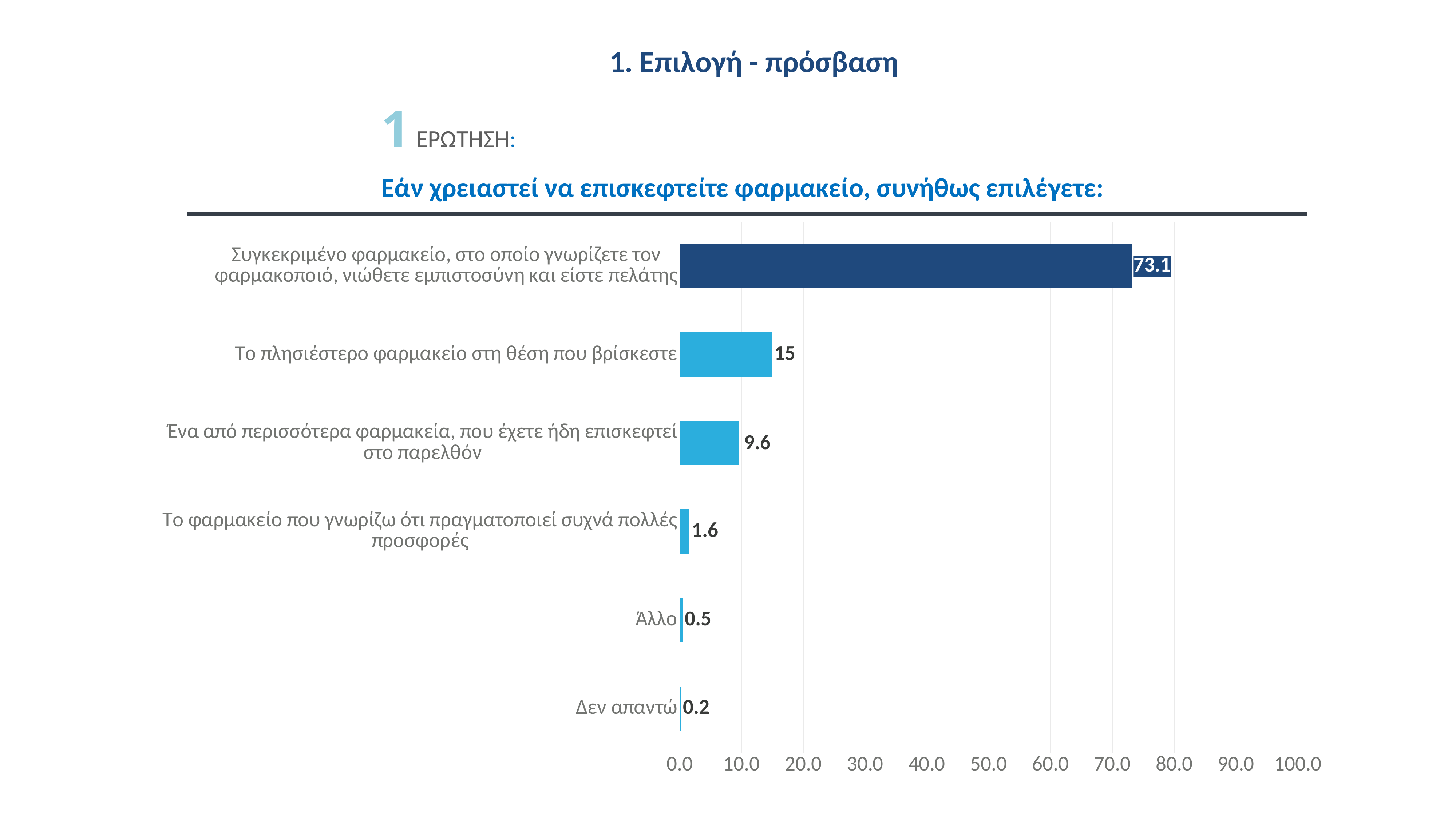
How many categories are shown in the chart? 6 Is the value for "Συγκεκριμένο φαρμακείο, στο οποίο γνωρίζετε τον φαρμακοποιό, νιώθετε εμπιστοσύνη και είστε πελάτης" greater or less than 70.0? greater Which is larger: the value for "Το φαρμακείο που γνωρίζω ότι πραγματοποιεί συχνά πολλές προσφορές" or the value for "Άλλο"? Το φαρμακείο που γνωρίζω ότι πραγματοποιεί συχνά πολλές προσφορές What is the value for "Δεν απαντώ"? 0.2 Which category has the lowest value? Δεν απαντώ What kind of chart is shown on the slide? bar chart What is the value for "Ένα από περισσότερα φαρμακεία, που έχετε ήδη επισκεφτεί στο παρελθόν"? 9.6 Which category has the highest value? Συγκεκριμένο φαρμακείο, στο οποίο γνωρίζετε τον φαρμακοποιό, νιώθετε εμπιστοσύνη και είστε πελάτης What is the value for "Άλλο"? 0.5 What is the value for "Το πλησιέστερο φαρμακείο στη θέση που βρίσκεστε"? 15 What is the difference between the values for "Το πλησιέστερο φαρμακείο στη θέση που βρίσκεστε" and "Ένα από περισσότερα φαρμακεία, που έχετε ήδη επισκεφτεί στο παρελθόν"? 5.4 What is the question shown as the chart's title? Εάν χρειαστεί να επισκεφτείτε φαρμακείο, συνήθως επιλέγετε: